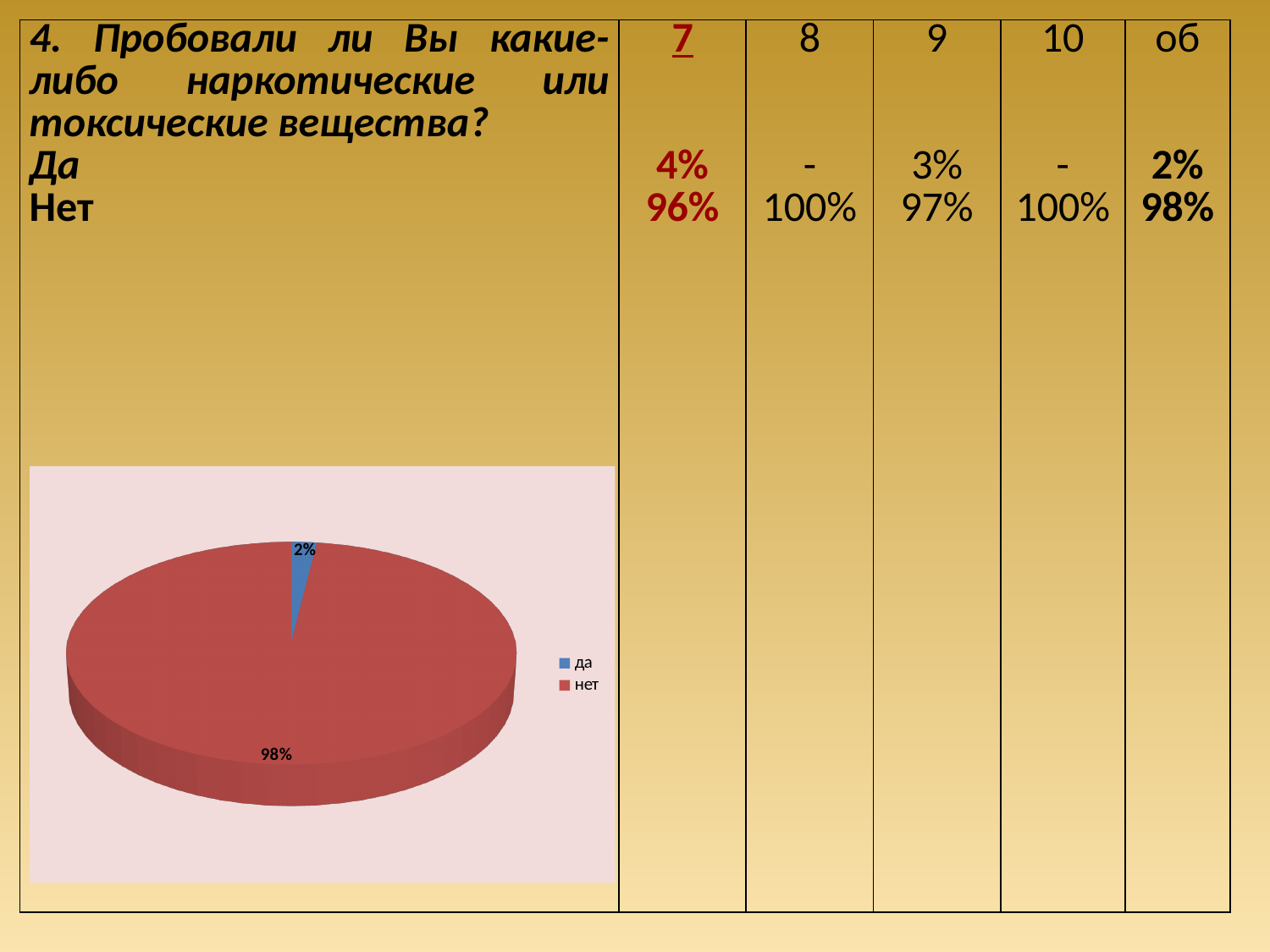
Which slice of the pie chart is the smallest? да What colour is the "нет" slice in the pie chart? red How many slices does the pie chart have? 2 What is the difference between the "нет" and "да" shares in the pie chart? 96% What colour is the "да" slice in the pie chart? blue What share of the pie chart is labelled "да"? 2% What share of the pie chart is labelled "нет"? 98% How many entries does the legend of the pie chart list? 2 Which is larger in the pie chart, the "да" slice or the "нет" slice? нет Which slice of the pie chart is the largest? нет What kind of chart is shown on the slide? pie chart